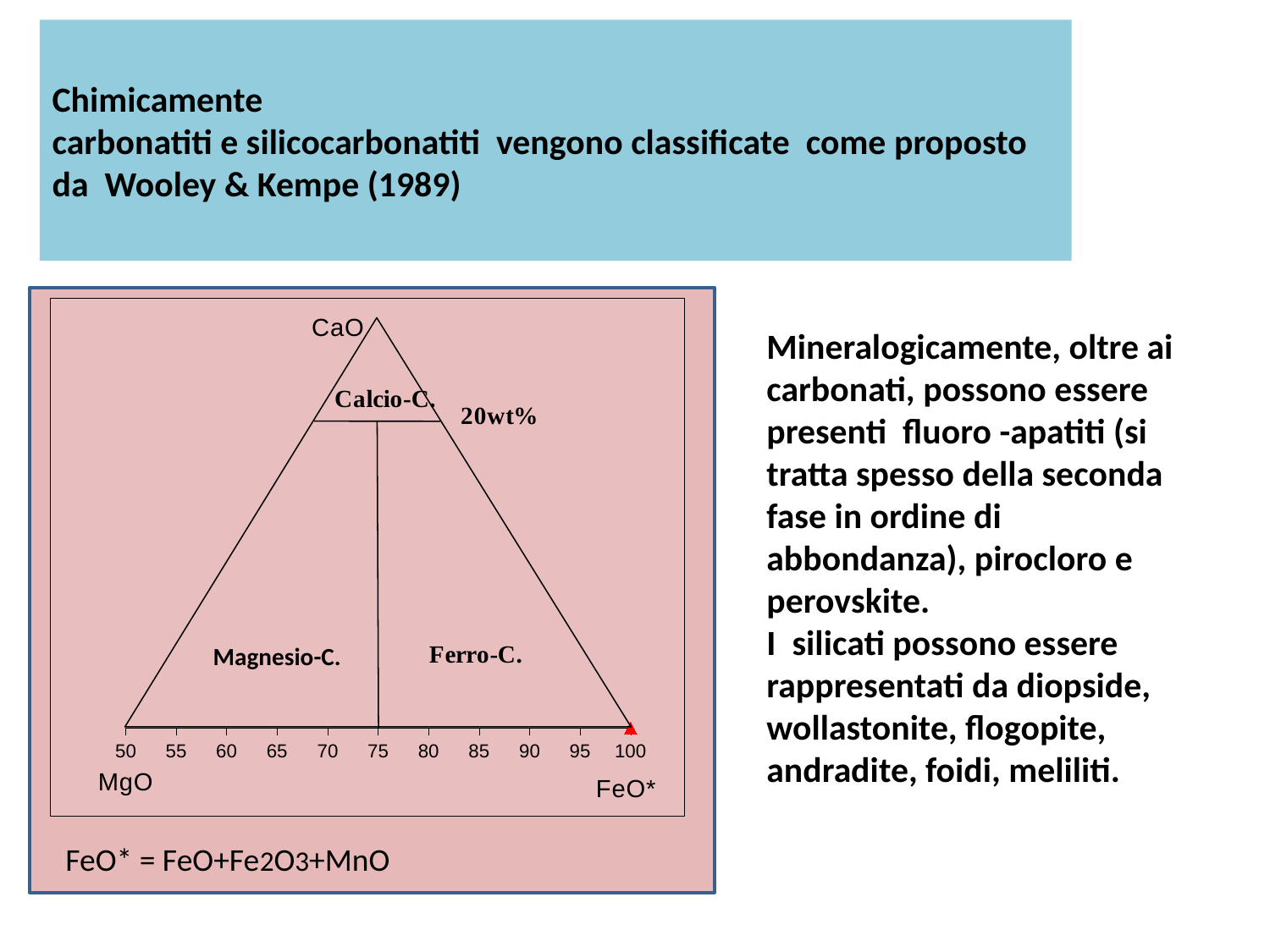
What percentage label is written next to the horizontal line below the Calcio-C. field? 20wt% Which component is labelled at the bottom-right corner of the triangle? FeO* What kind of chart is shown on the slide? Ternary diagram What is the highest tick value shown on the bottom axis of the triangle? 100 How many tick values are printed along the bottom axis of the triangle? 11 How many classification fields are labelled inside the triangle? 3 At which value on the bottom axis is the red triangle marker placed? 100 According to the note below the diagram, what is FeO* equal to? FeO+Fe2O3+MnO Which component is labelled at the bottom-left corner of the triangle? MgO What is the lowest tick value shown on the bottom axis of the triangle? 50 At which value on the bottom axis does the vertical line separating Magnesio-C. from Ferro-C. meet the base? 75 Which component is labelled at the top apex of the triangle? CaO